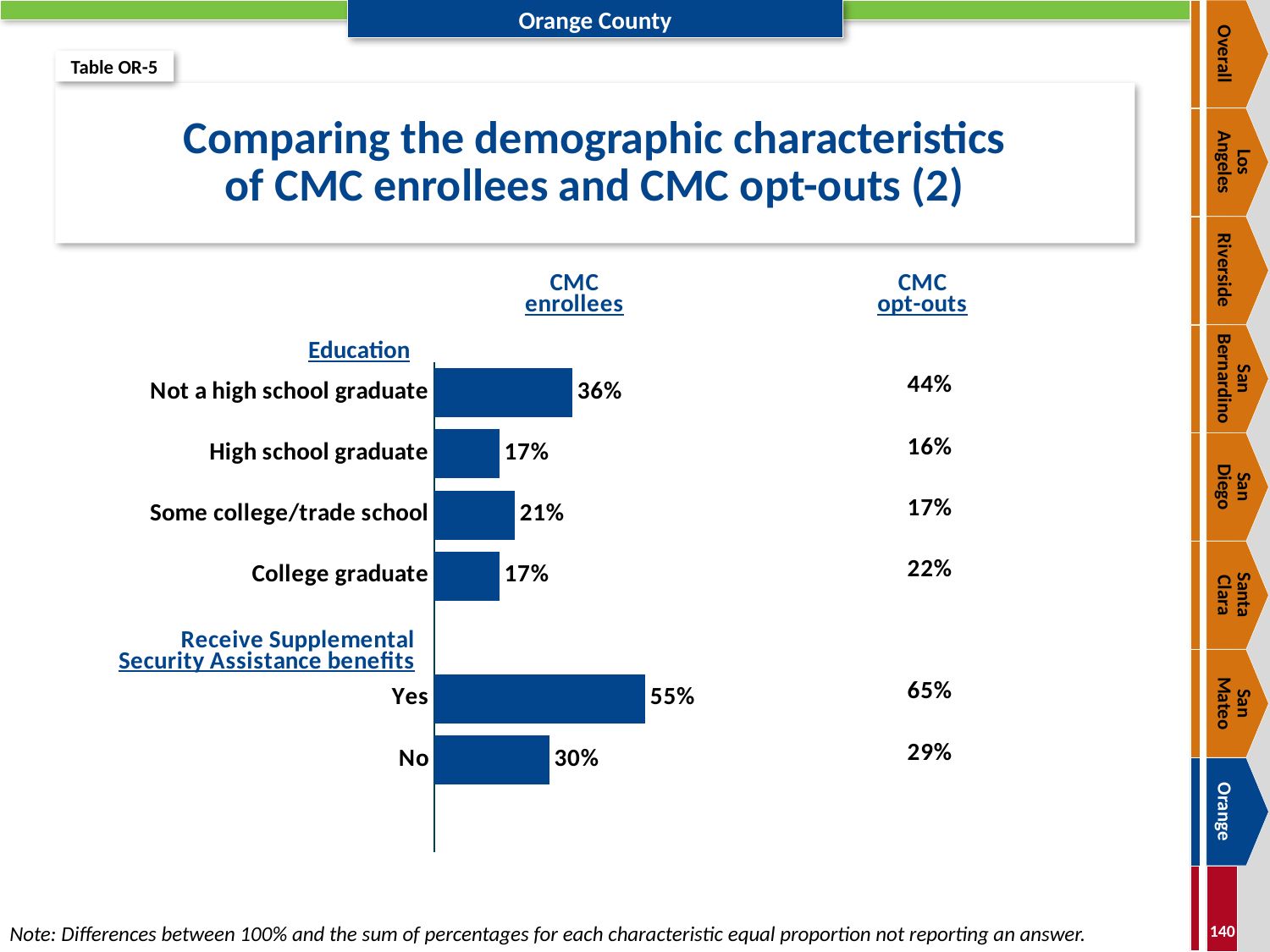
What type of chart is used to show the CMC enrollees percentages? Bar chart What percentage of CMC enrollees have some college/trade school education? 21% Which is larger for college graduates: the CMC enrollees percentage or the CMC opt-outs percentage? CMC opt-outs What is the title of the chart? Comparing the demographic characteristics of CMC enrollees and CMC opt-outs (2) What percentage of CMC opt-outs are college graduates? 22% Which education category has the highest percentage among CMC enrollees? Not a high school graduate What percentage of CMC enrollees are not a high school graduate? 36% What is the difference between the CMC opt-outs and CMC enrollees percentages for 'Not a high school graduate'? 8% What percentage of CMC enrollees receive Supplemental Security Assistance benefits (Yes)? 55% What is the difference between the 'Yes' and 'No' percentages for CMC enrollees receiving Supplemental Security Assistance benefits? 25% What percentage of CMC opt-outs are not a high school graduate? 44% How many education categories are shown in the chart? 4